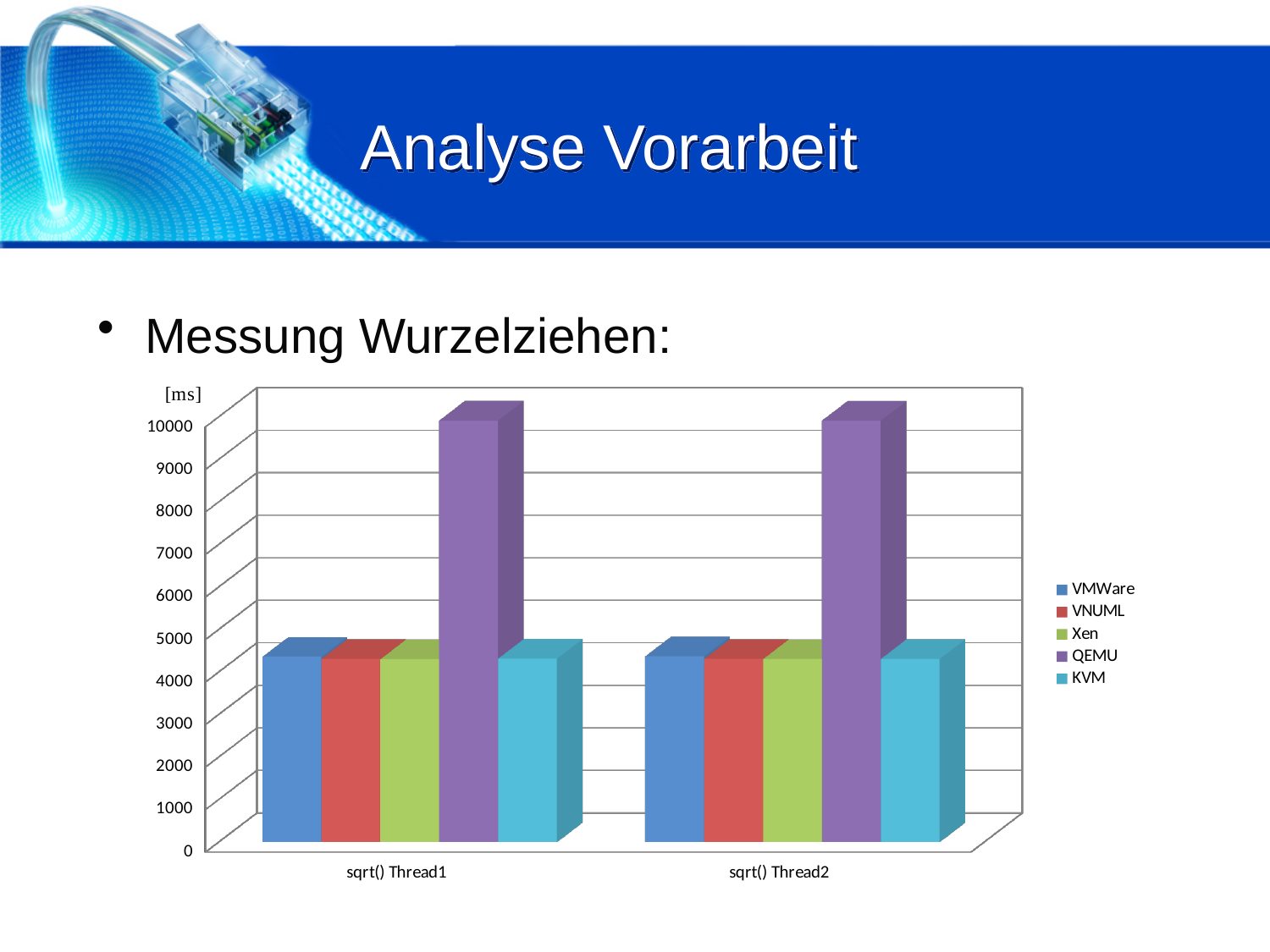
Which series has the highest value for sqrt() Thread2? QEMU How many categories are shown on the x axis? 2 Which is larger: the value for QEMU or the value for VNUML in sqrt() Thread2? QEMU How many series does the legend list? 5 Is the value for QEMU in sqrt() Thread1 greater or less than 9000? greater What unit is shown on the y axis of the chart? [ms] What kind of chart is shown on the slide? bar chart Is the value for KVM in sqrt() Thread2 greater or less than 3000? greater Is the value for VMWare in sqrt() Thread1 greater or less than 5000? less Which series is shown in purple in the legend? QEMU Which series has the highest value for sqrt() Thread1? QEMU